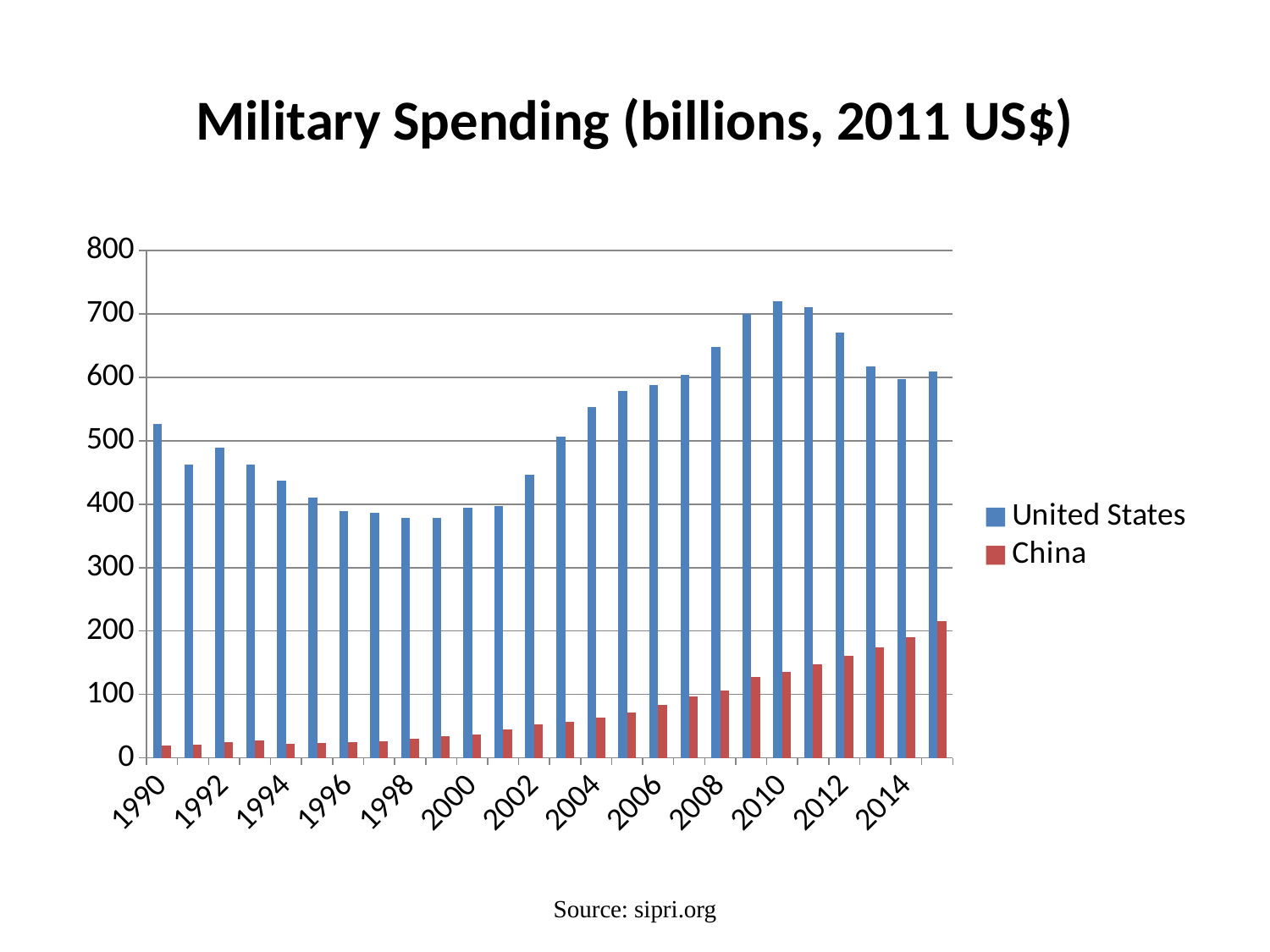
Is the China value for 2000 greater or less than 50? less Is the United States value for 1996 greater or less than 400? less Is the United States value for 1990 greater or less than 500? greater In 2010, which is larger, the United States value or the China value? United States What kind of chart is shown on the slide? bar chart Which series is shown in red? China How many series does the legend list? 2 What is the title of the chart? Military Spending (billions, 2011 US$) Do China's values rise or fall from 1990 to 2015? rise In which year is China's military spending highest? 2015